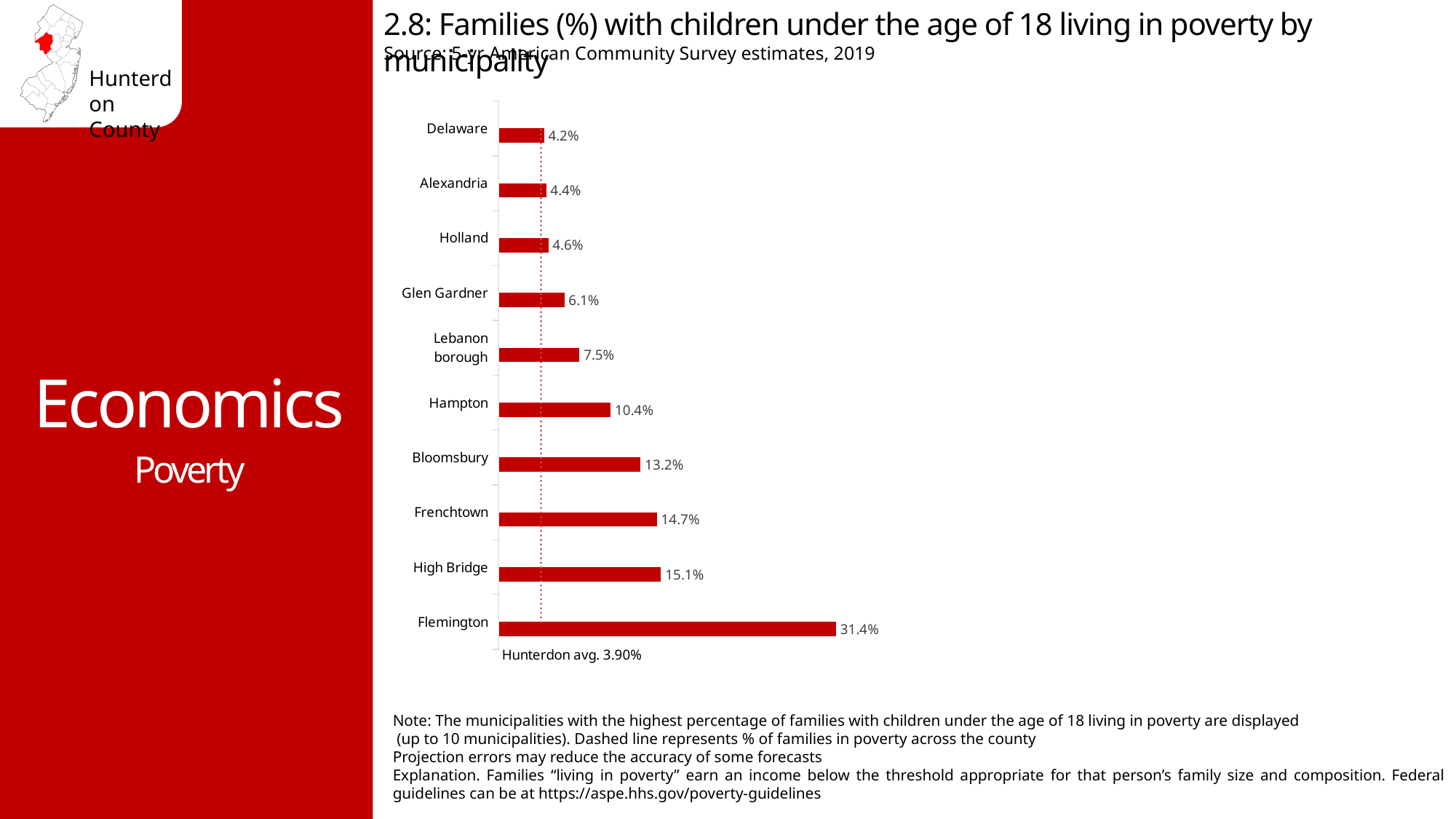
Which municipality has the lowest value? Delaware What is the difference between the values for Flemington and High Bridge? 16.3% What is the Hunterdon average shown by the dashed line? 3.90% Which has a larger value, Frenchtown or Hampton? Frenchtown How many municipalities are shown in the chart? 10 What is the value for Flemington? 31.4% Which municipality has the highest value? Flemington What is the difference between the values for Bloomsbury and Glen Gardner? 7.1% What is the value for Hampton? 10.4% What is the value for Lebanon borough? 7.5% What kind of chart is shown? Bar chart What is the value for Holland? 4.6%